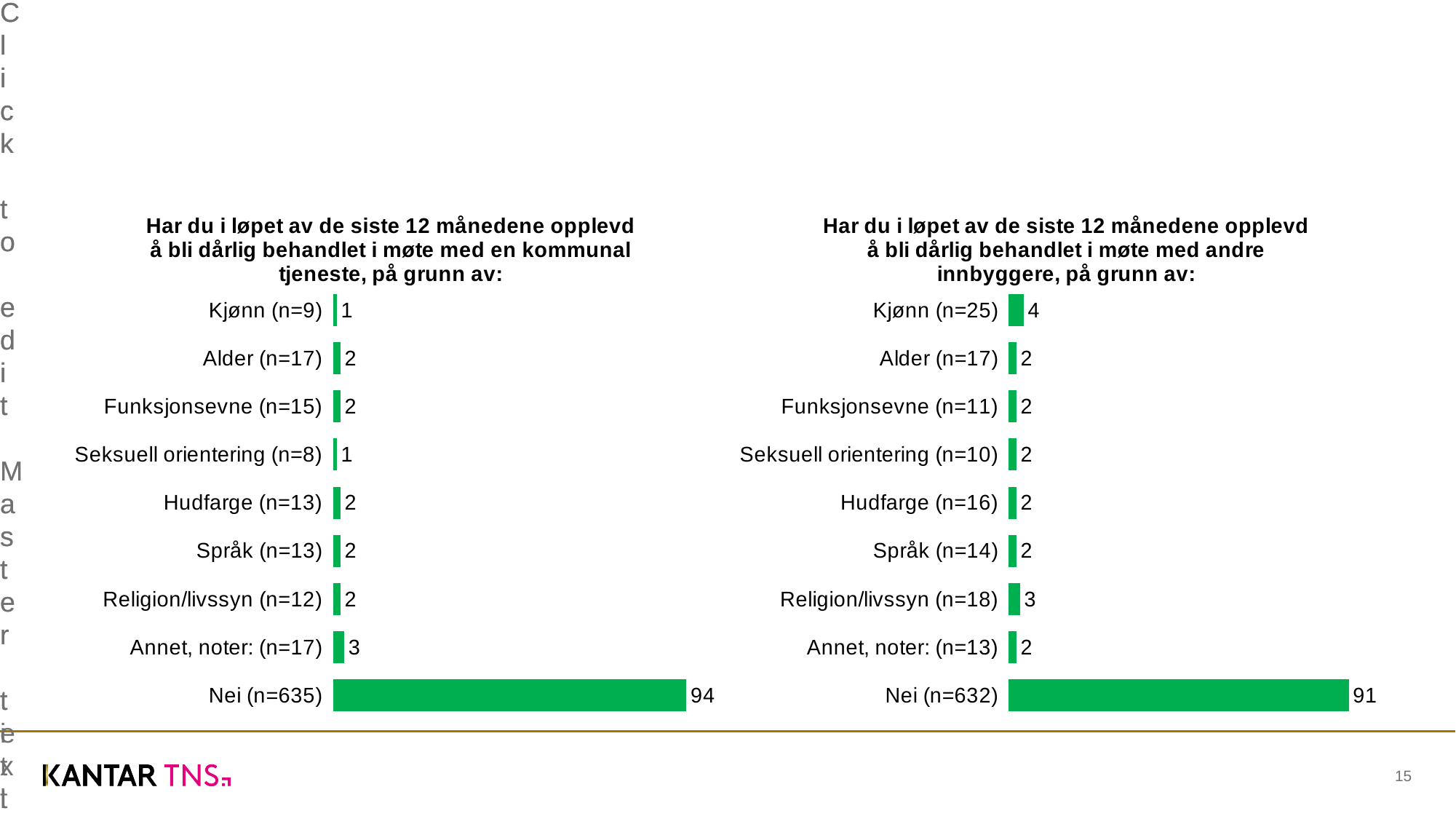
In the right chart (andre innbyggere), what is the value for Religion/livssyn (n=18)? 3 What kind of chart is the right chart (andre innbyggere)? Bar chart In the right chart (andre innbyggere), what is the difference between the values for Kjønn (n=25) and Alder (n=17)? 2 What colour are the bars in both charts? Green In the left chart (kommunal tjeneste), what is the difference between the values for Nei (n=635) and Annet, noter: (n=17)? 91 Which is larger: the value for Nei in the left chart (kommunal tjeneste) or the value for Nei in the right chart (andre innbyggere)? Nei in the left chart (94) In the left chart (kommunal tjeneste), what is the value for Annet, noter: (n=17)? 3 How many categories does the left chart (kommunal tjeneste) show? 9 In the left chart (kommunal tjeneste), which category has the highest value? Nei (n=635) In the right chart (andre innbyggere), which category has the highest value? Nei (n=632) In the left chart (kommunal tjeneste), what is the value for Nei (n=635)? 94 In the right chart (andre innbyggere), what is the value for Kjønn (n=25)? 4